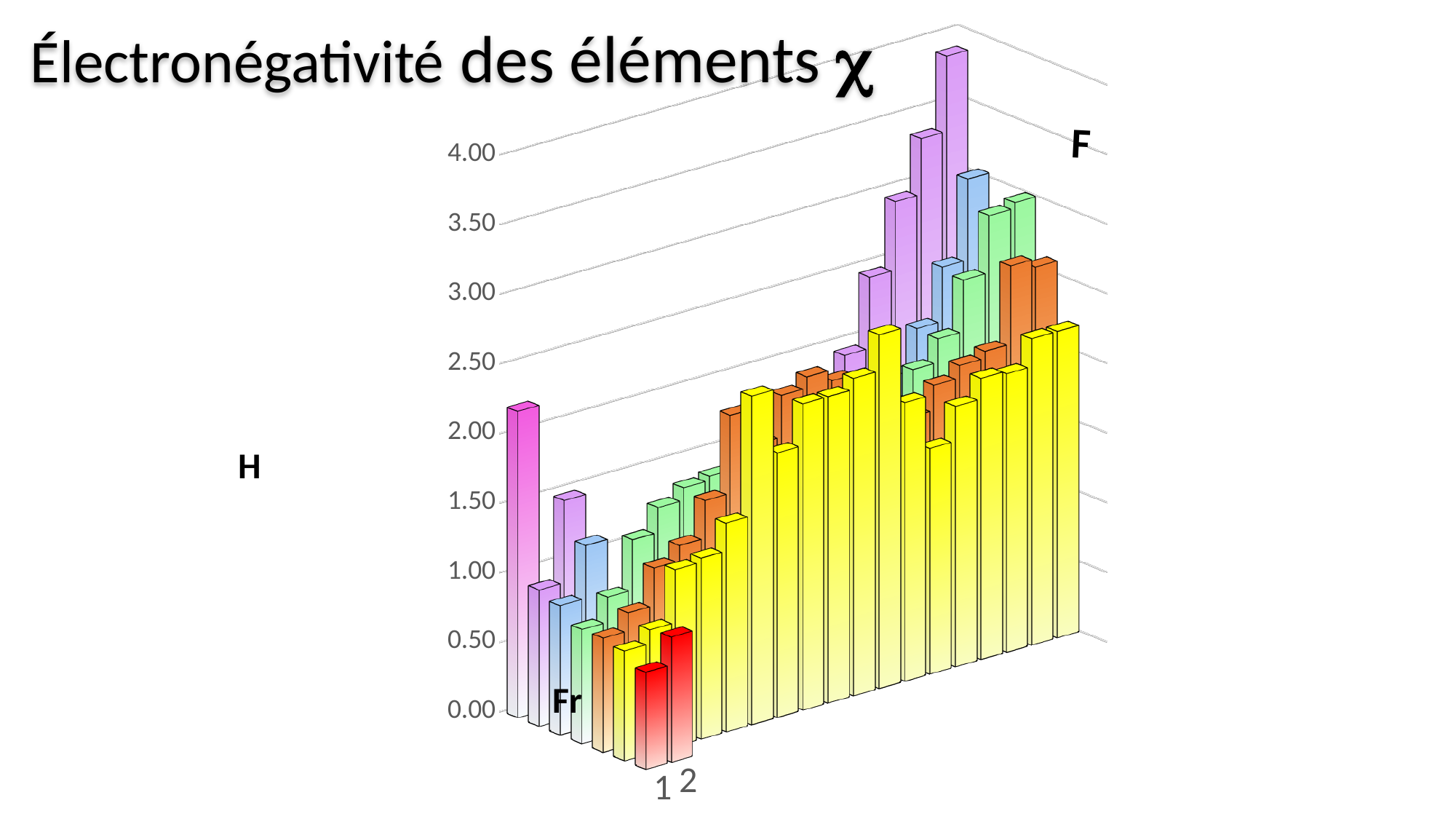
Which labeled element has the tallest bar? F What is the title of the chart? Électronégativité des éléments χ Is the bar for Fr greater or less than 1.50? less Which is larger, the bar for H or the bar for Fr? H What is the interval between consecutive tick marks on the vertical axis? 0.50 What is the highest value shown on the vertical axis? 4.00 Is the bar for F greater or less than 3.50? greater Is the bar for H greater or less than 3.00? less Which labeled element has the shortest bar, H, Fr or F? Fr What kind of chart is shown on the slide? bar chart Which is larger, the bar for F or the bar for H? F